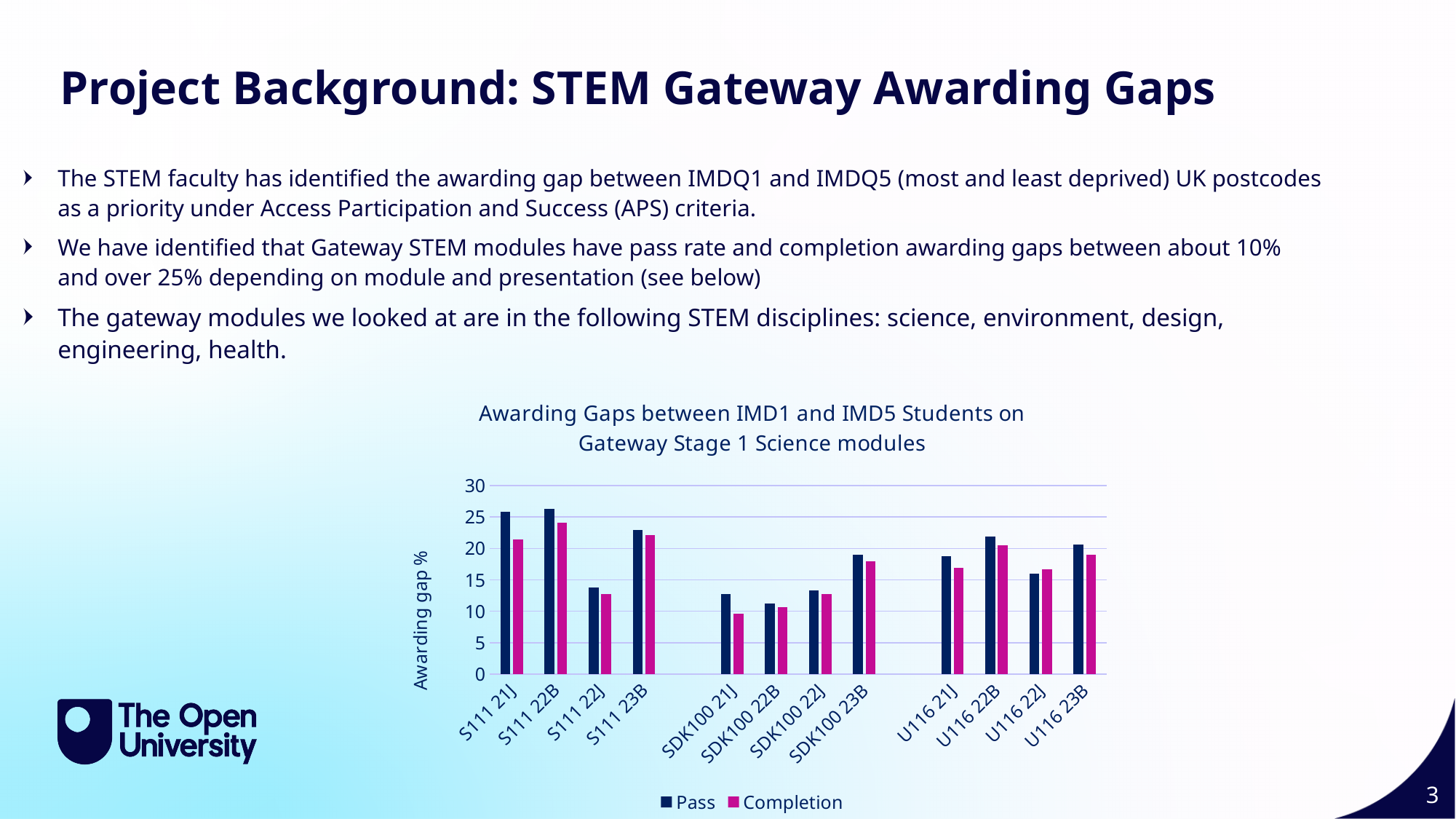
For SDK100 21J, which is larger: the Pass gap or the Completion gap? Pass Is the Pass value for U116 22B greater or less than 20? greater What kind of chart is shown on the slide? Bar chart Which category has the highest Completion awarding gap? S111 22B How many series does the chart legend list? 2 Which category has the lowest Pass awarding gap? SDK100 22B Which category has the lowest Completion awarding gap? SDK100 21J How many module presentations (categories) are shown on the x axis of the chart? 12 Which is larger: the Completion gap for S111 22B or the Completion gap for U116 22B? S111 22B Is the Pass value for S111 22J greater or less than 15? less What is the label on the vertical axis of the chart? Awarding gap %